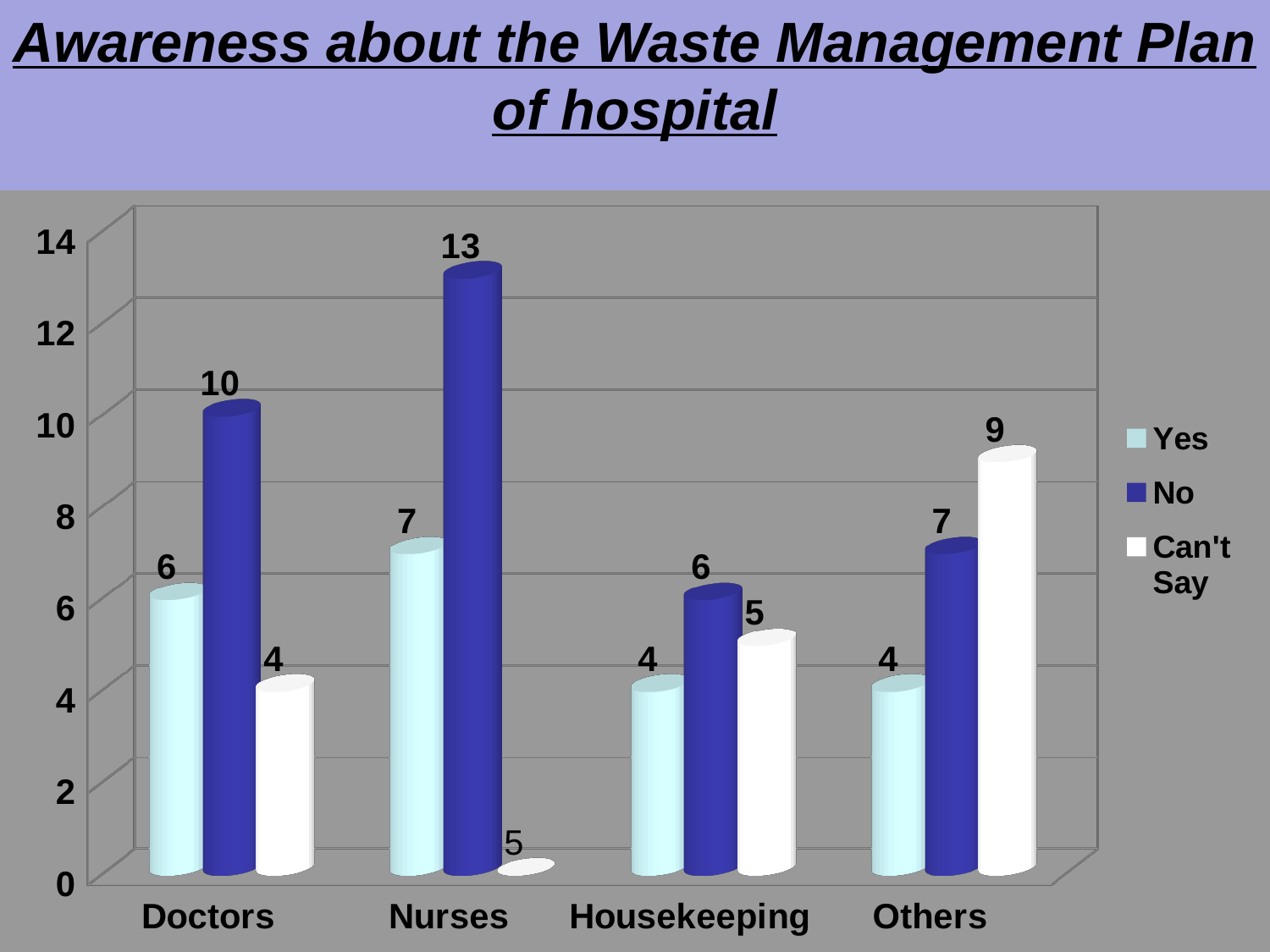
What is the difference between the 'No' value for Nurses and the 'No' value for Doctors? 3 What is the 'Can't Say' value for Housekeeping? 5 What is the title of the chart? Awareness about the Waste Management Plan of hospital What is the 'Can't Say' value for Others? 9 What is the 'Yes' value for Doctors? 6 Which category has the lowest 'No' value? Housekeeping What is the 'No' value for Nurses? 13 What type of chart is shown on the slide? bar chart Which category has the highest 'No' value? Nurses How many series does the legend list? 3 Which is larger: the 'Yes' value for Nurses or the 'Yes' value for Housekeeping? Nurses How many categories are shown on the x axis? 4